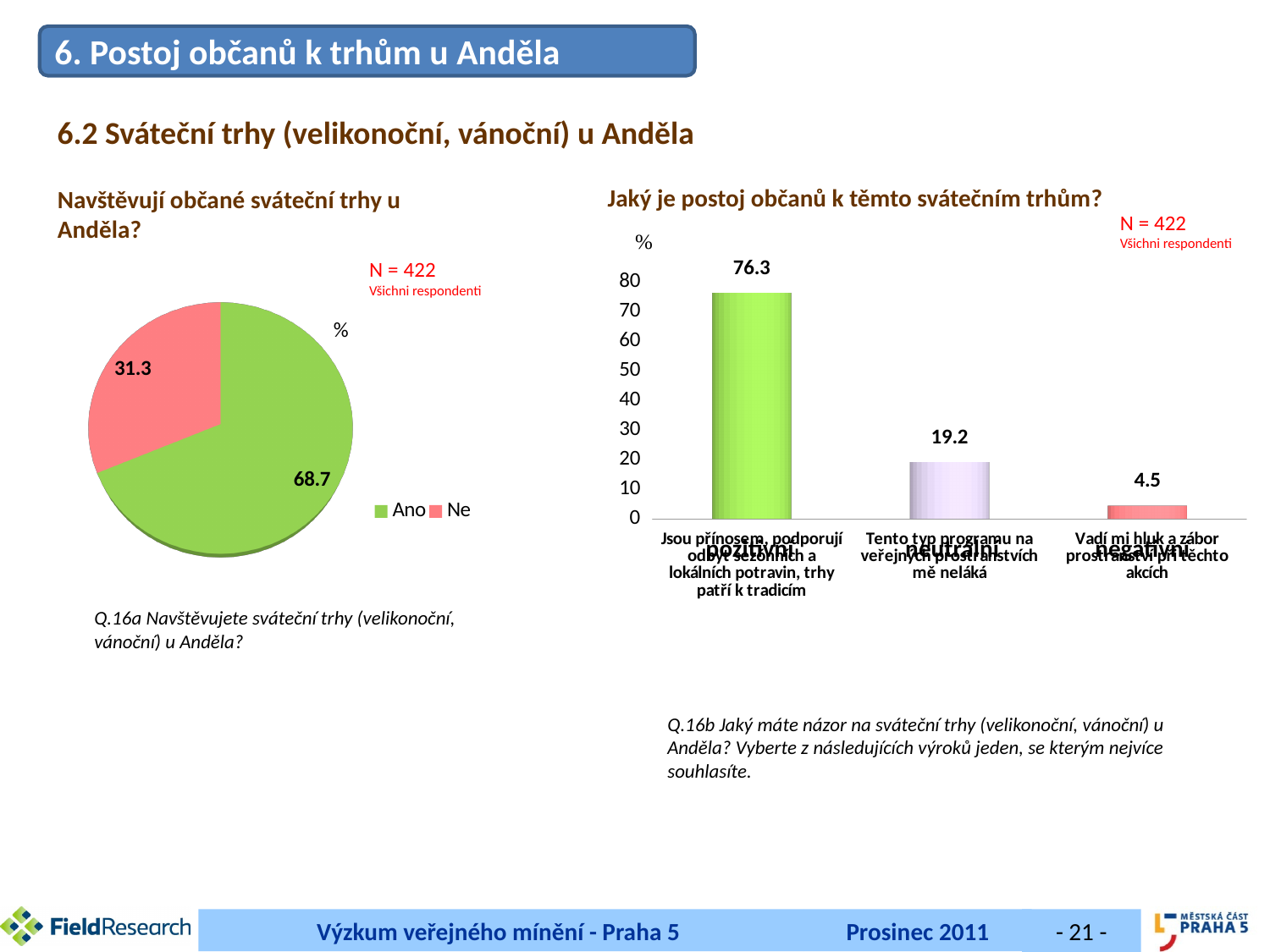
In the bar chart on the right, what is the value for the "negativní" category? 4.5 How many entries does the legend of the pie chart on the left list? 2 In the bar chart on the right, what is the difference between the "pozitivní" and "neutrální" values? 57.1 In the bar chart on the right, what is the value for the "neutrální" category? 19.2 In the pie chart on the left, what percentage of respondents answered "Ano"? 68.7 In the bar chart on the right, which category has the lowest value? negativní In the pie chart on the left, what is the difference between the "Ano" and "Ne" shares? 37.4 In the bar chart on the right, what is the value for the "pozitivní" category? 76.3 What type of chart is the chart on the left of the slide? Pie chart In the pie chart on the left, what percentage of respondents answered "Ne"? 31.3 In the pie chart on the left, which answer has the larger share, "Ano" or "Ne"? Ano How many bars are shown in the bar chart on the right? 3